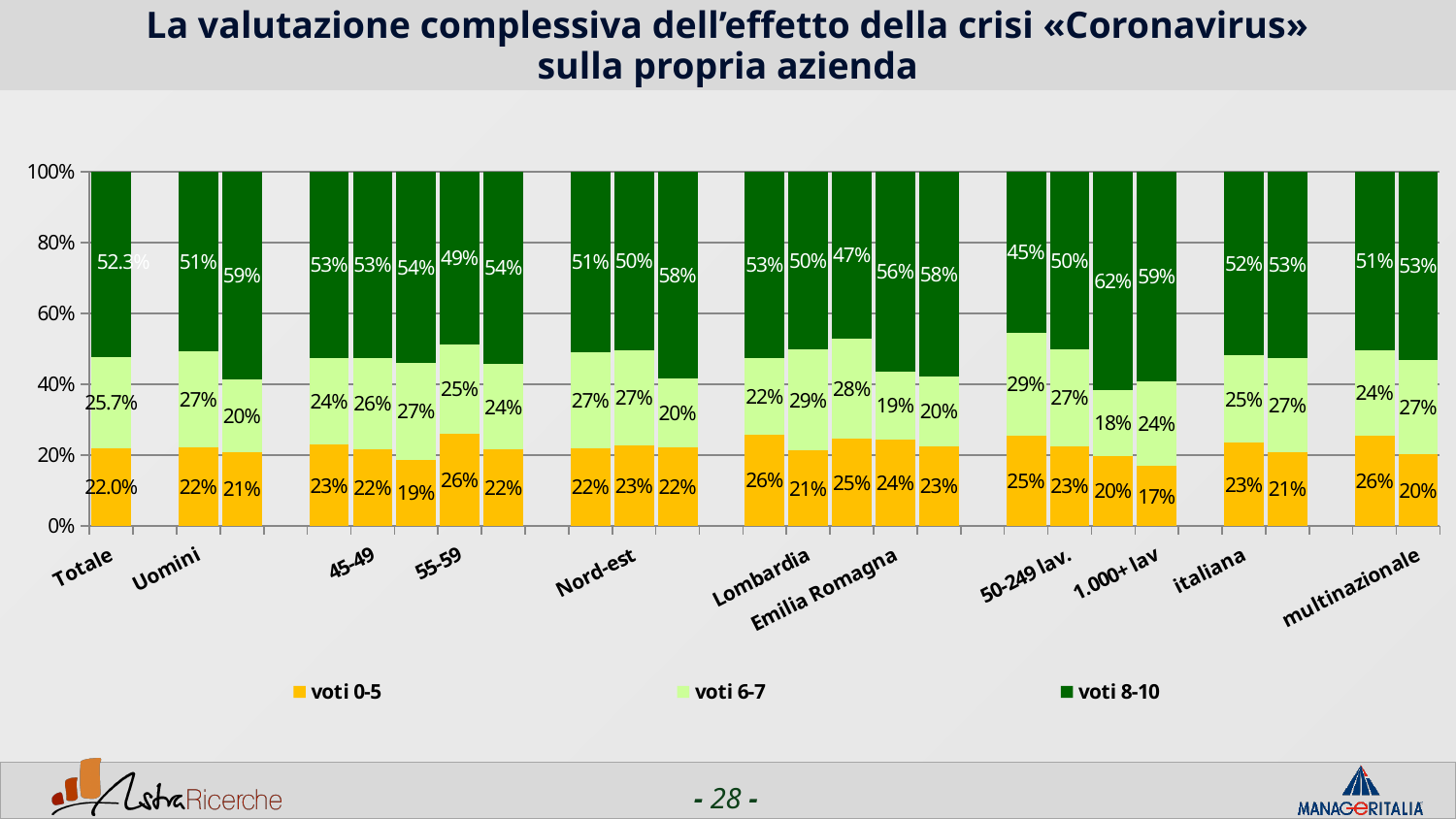
What is the value of 'voti 8-10' for Emilia Romagna? 56% What type of chart is shown on the slide? stacked bar chart Which is larger for Totale: 'voti 8-10' or 'voti 0-5'? voti 8-10 What is the value of 'voti 6-7' for Uomini? 27% What is the value of 'voti 0-5' for Totale? 22.0% What is the value of 'voti 8-10' for Uomini? 51% What is the value of 'voti 6-7' for Totale? 25.7% What is the value of 'voti 8-10' for Totale? 52.3% What is the value of 'voti 0-5' for 1.000+ lav? 17% How many series does the legend list? 3 What is the difference between 'voti 6-7' and 'voti 0-5' for Uomini? 5% Which legend entry is shown in dark green? voti 8-10